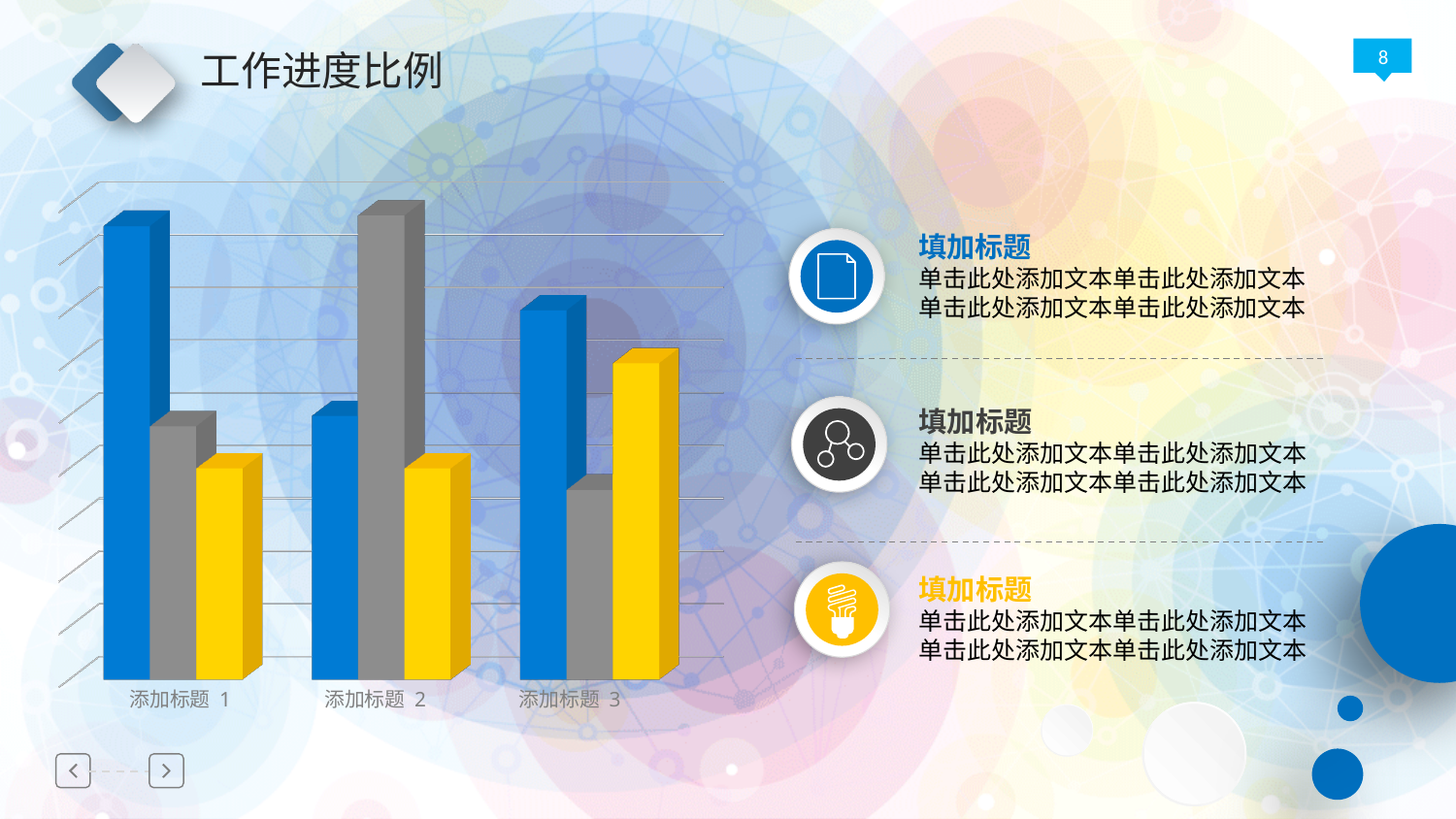
Which category has the shortest gray bar? 添加标题 3 How many categories are shown on the x axis of the chart? 3 In category 添加标题 3, which is larger, the yellow bar or the gray bar? yellow bar In category 添加标题 1, which is larger, the blue bar or the yellow bar? blue bar In category 添加标题 2, which is larger, the gray bar or the blue bar? gray bar Which category has the shortest blue bar? 添加标题 2 Which category has the tallest yellow bar? 添加标题 3 What kind of chart is shown on the slide? bar chart Which category has the tallest blue bar? 添加标题 1 How many bars are plotted for each category in the chart? 3 What colours are the three bar series in the chart? blue, gray, yellow Which category has the tallest gray bar? 添加标题 2